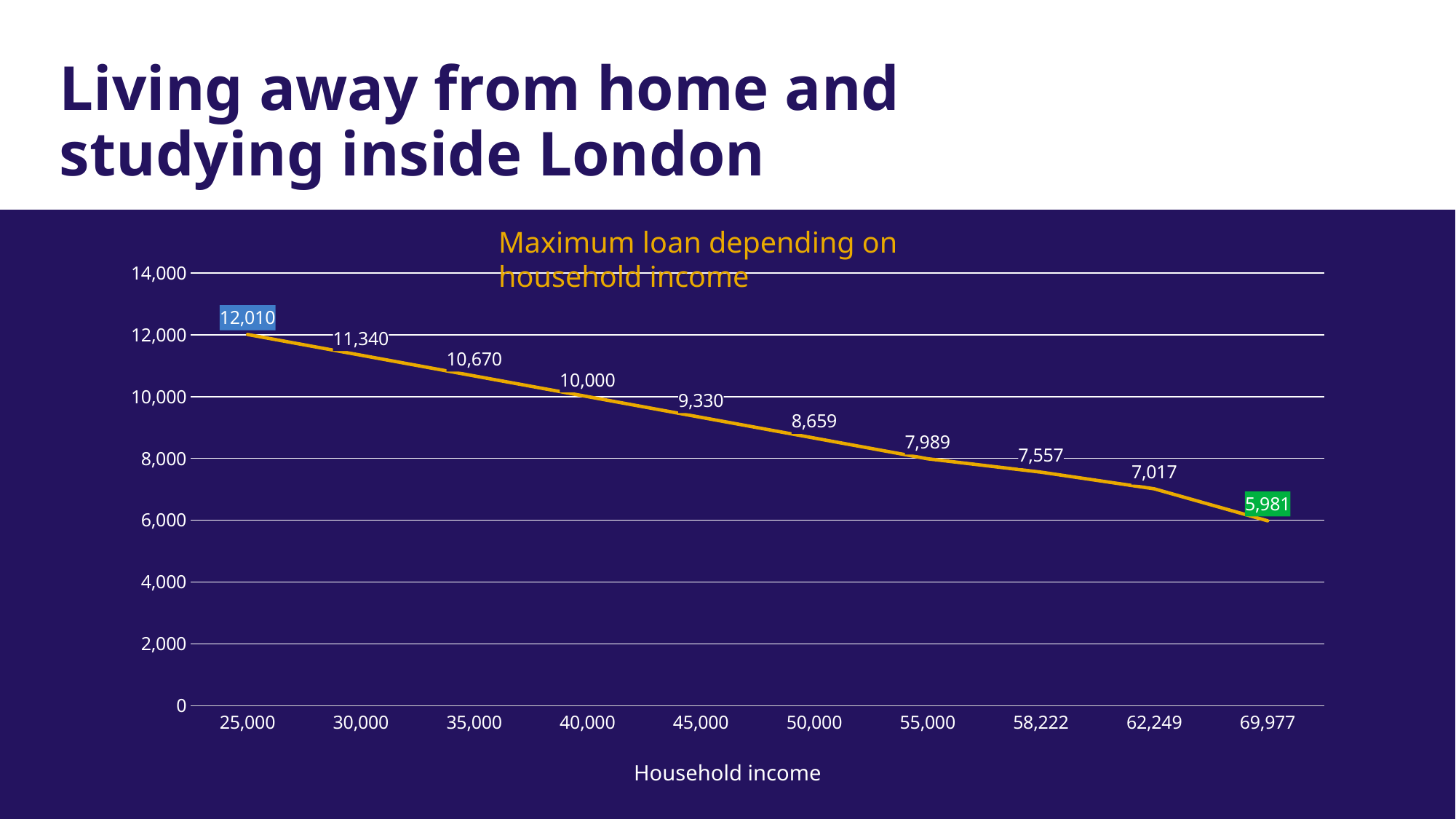
Does the maximum loan rise or fall as household income increases? Fall What is the maximum loan for a household income of 45,000? 9,330 Which is larger, the maximum loan at 35,000 or at 55,000 household income? 35,000 What is the difference between the maximum loan at 40,000 and at 50,000 household income? 1,341 Which household income has the lowest maximum loan? 69,977 How many household income points are plotted on the chart? 10 What kind of chart is shown on the slide? Line chart What is the maximum loan for a household income of 25,000? 12,010 Which household income has the highest maximum loan? 25,000 What is the maximum loan for a household income of 58,222? 7,557 What is the difference between the maximum loan at 25,000 and at 69,977 household income? 6,029 What is the maximum loan for a household income of 69,977? 5,981